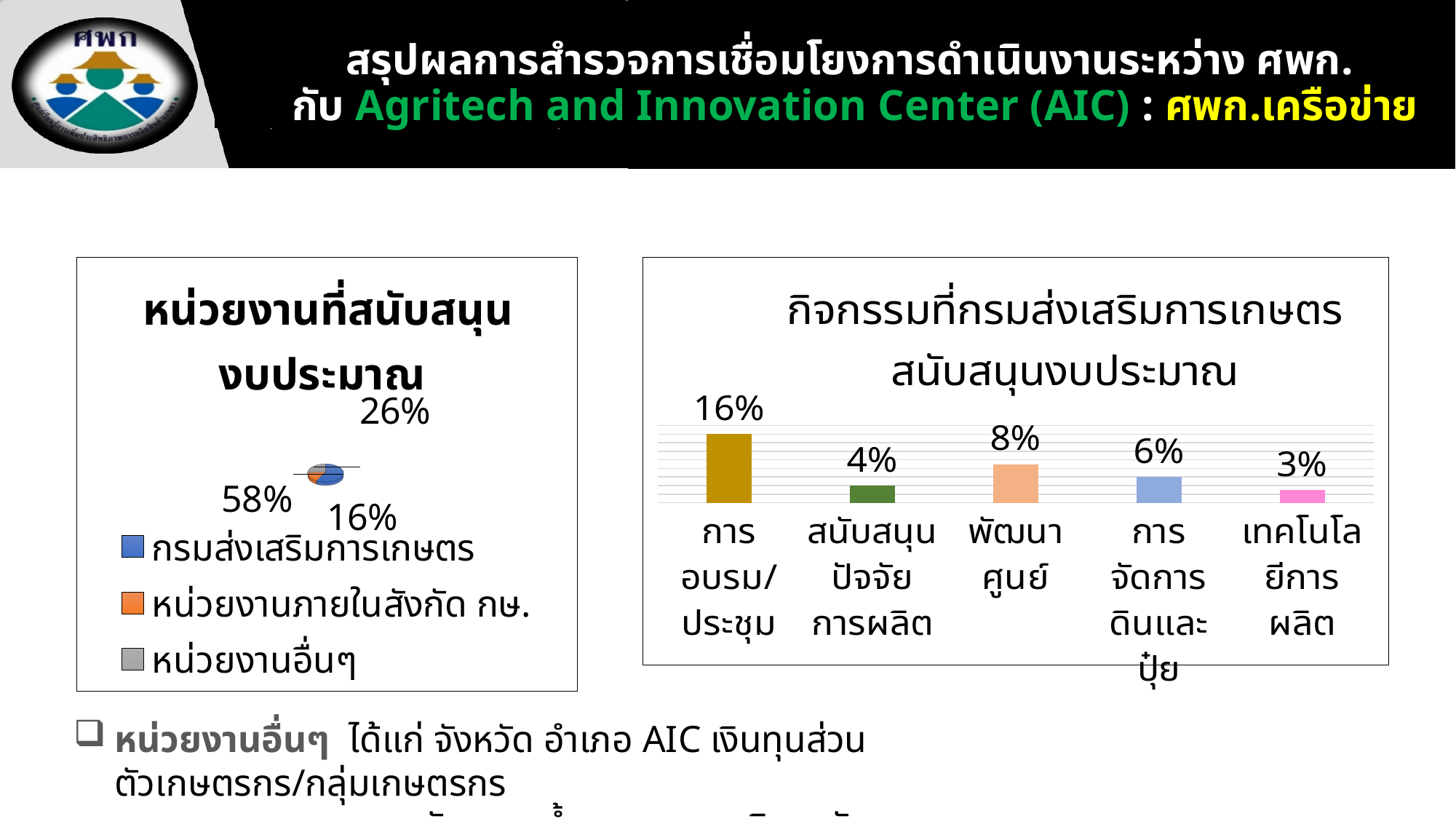
In the bar chart titled กิจกรรมที่กรมส่งเสริมการเกษตรสนับสนุนงบประมาณ, what is the value for พัฒนาศูนย์? 8% In the bar chart titled กิจกรรมที่กรมส่งเสริมการเกษตรสนับสนุนงบประมาณ, what is the value for สนับสนุนปัจจัยการผลิต? 4% In the bar chart on the right, what is the difference between the values for การอบรม/ประชุม and พัฒนาศูนย์? 8% How many entries does the legend of the pie chart on the left list? 3 In the bar chart titled กิจกรรมที่กรมส่งเสริมการเกษตรสนับสนุนงบประมาณ, what is the value for เทคโนโลยีการผลิต? 3% In the bar chart on the right, which is larger: the value for การจัดการดินและปุ๋ย or the value for สนับสนุนปัจจัยการผลิต? การจัดการดินและปุ๋ย What kind of chart is the chart titled หน่วยงานที่สนับสนุนงบประมาณ on the left? Pie chart How many categories are shown in the bar chart on the right? 5 In the bar chart on the right, which category has the highest value? การอบรม/ประชุม In the bar chart titled กิจกรรมที่กรมส่งเสริมการเกษตรสนับสนุนงบประมาณ, what is the value for การจัดการดินและปุ๋ย? 6% In the bar chart on the right, which category has the lowest value? เทคโนโลยีการผลิต In the bar chart titled กิจกรรมที่กรมส่งเสริมการเกษตรสนับสนุนงบประมาณ, what is the value for การอบรม/ประชุม? 16%